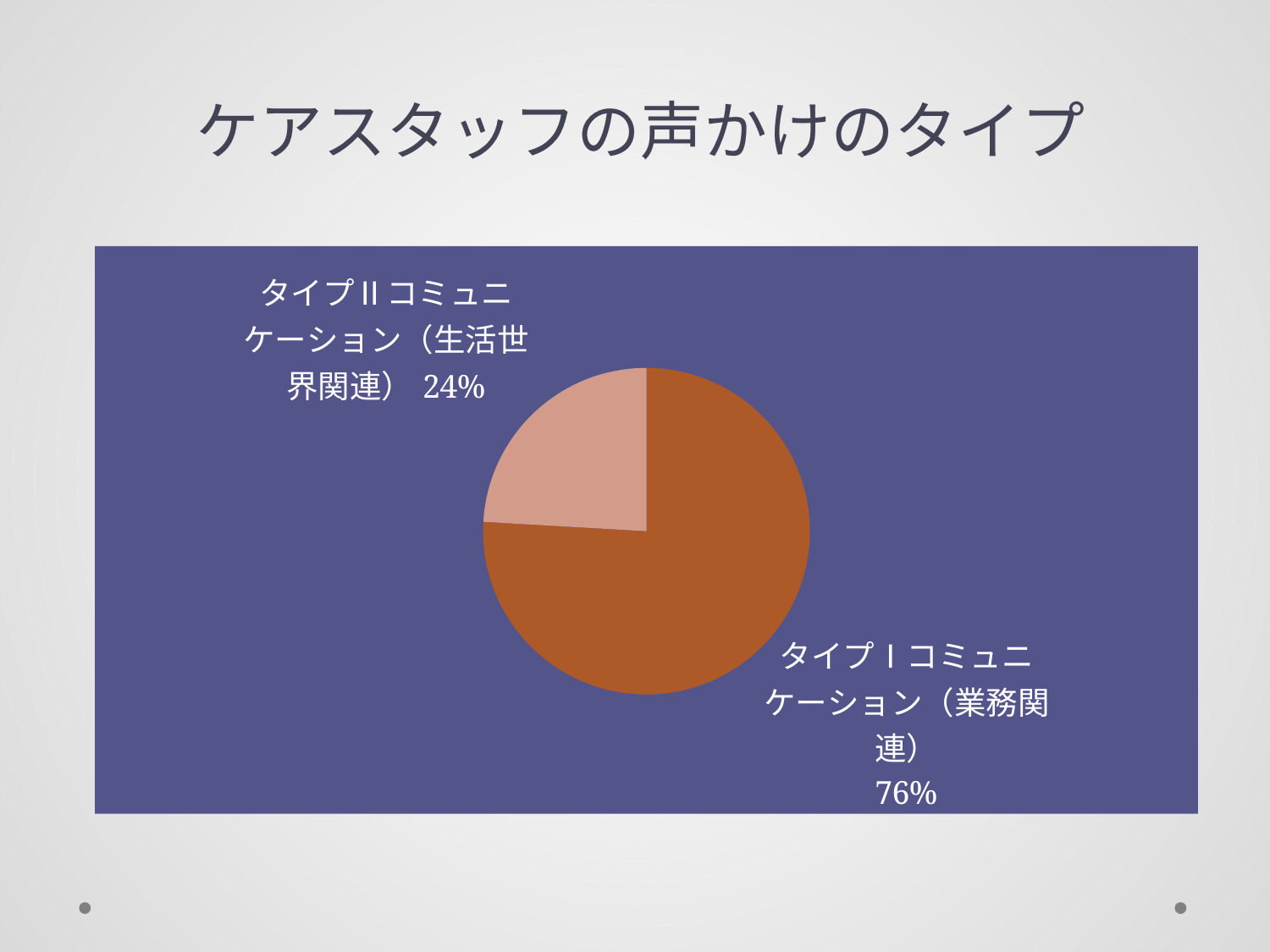
What kind of chart is shown on the slide? pie chart What is the title of the slide containing the pie chart? ケアスタッフの声かけのタイプ How many slices does the pie chart have? 2 Which is larger, the share for タイプⅠコミュニケーション（業務関連） or タイプⅡコミュニケーション（生活世界関連）? タイプⅠコミュニケーション（業務関連） Which slice of the pie is the smallest? タイプⅡコミュニケーション（生活世界関連） What share of the pie does タイプⅡコミュニケーション（生活世界関連） have? 24% Which slice of the pie is the largest? タイプⅠコミュニケーション（業務関連） What colour is the slice for タイプⅡコミュニケーション（生活世界関連）? light pink What is the difference in percentage points between タイプⅠ and タイプⅡ? 52 What share of the pie does タイプⅠコミュニケーション（業務関連） have? 76%